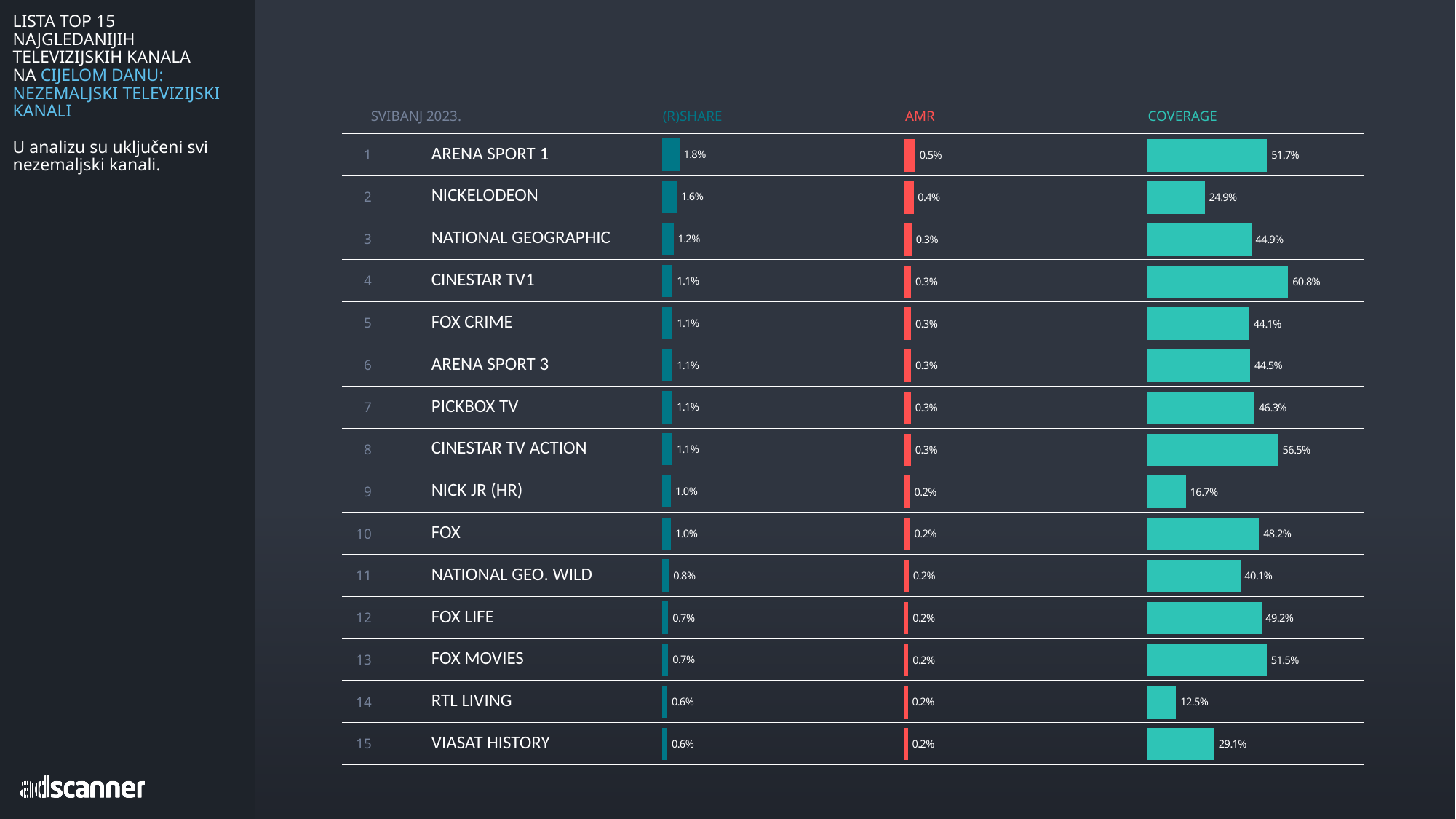
In the COVERAGE chart, which is larger: FOX MOVIES or NICKELODEON? FOX MOVIES In the AMR chart, what is the value for ARENA SPORT 1? 0.5% In the COVERAGE chart, what is the value for NICK JR (HR)? 16.7% In the COVERAGE chart, which channel has the lowest value? RTL LIVING How many channels are listed in the charts on this slide? 15 In the COVERAGE chart, what is the value for ARENA SPORT 1? 51.7% What are the three column headings of the charts on this slide? (R)SHARE, AMR, COVERAGE In the COVERAGE chart, what is the difference between CINESTAR TV1 and RTL LIVING? 48.3% In the COVERAGE chart, which channel has the highest value? CINESTAR TV1 In the (R)SHARE chart, which channel has the highest value? ARENA SPORT 1 What kind of chart is used to show the COVERAGE values? Bar chart In the (R)SHARE chart, what is the value for NICKELODEON? 1.6%